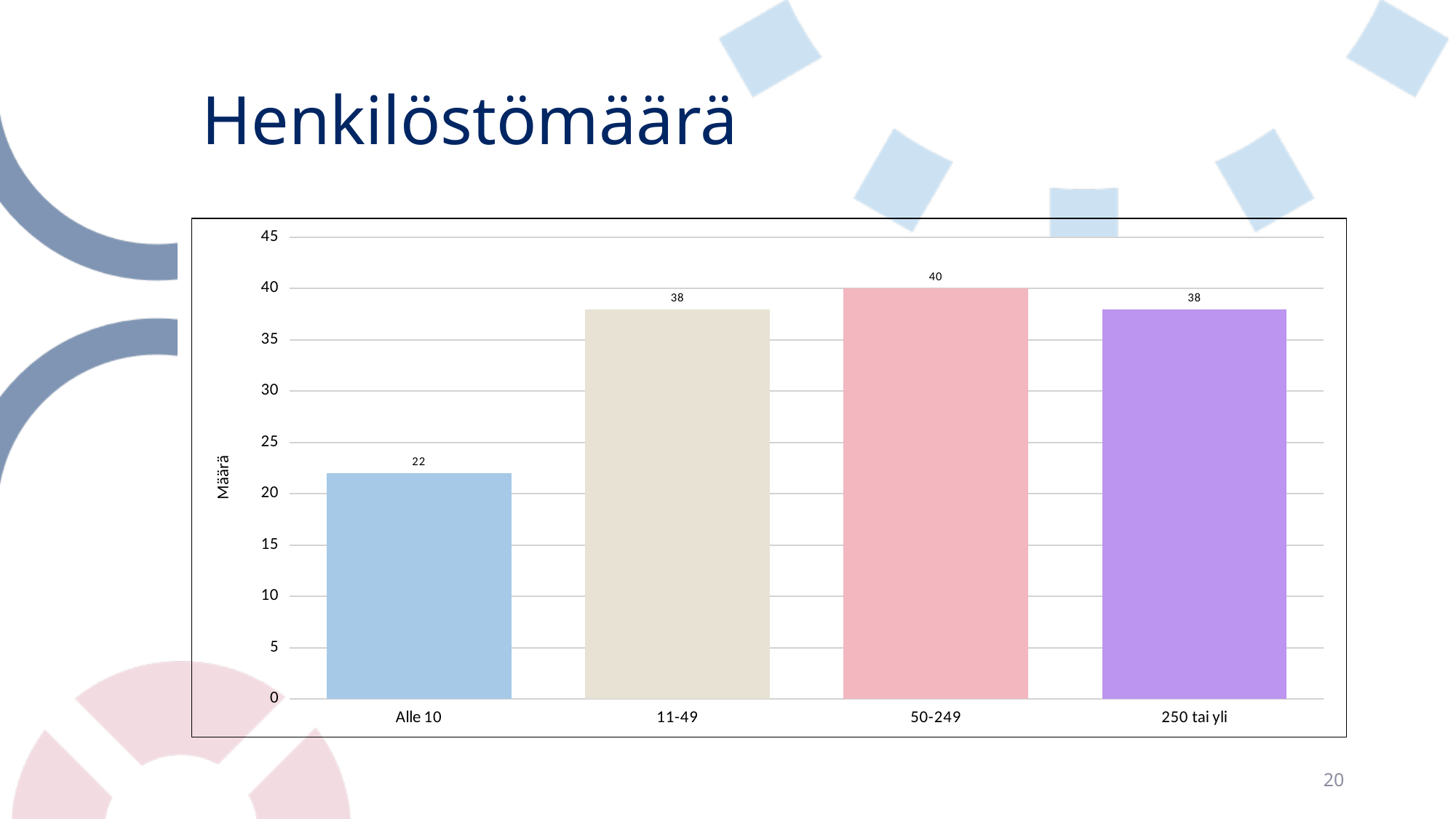
What is the value for the '50-249' category? 40 How many categories are shown on the x axis? 4 Which category has the lowest value? Alle 10 What is the value for the '250 tai yli' category? 38 What kind of chart is shown on the slide? Bar chart Is the value for '11-49' greater or less than 35? greater Which is larger, the value for '11-49' or the value for 'Alle 10'? 11-49 What is the label of the vertical axis? Määrä Which category has the highest value? 50-249 What is the value for the 'Alle 10' category? 22 What is the difference between the values for '50-249' and 'Alle 10'? 18 What is the title of the slide? Henkilöstömäärä